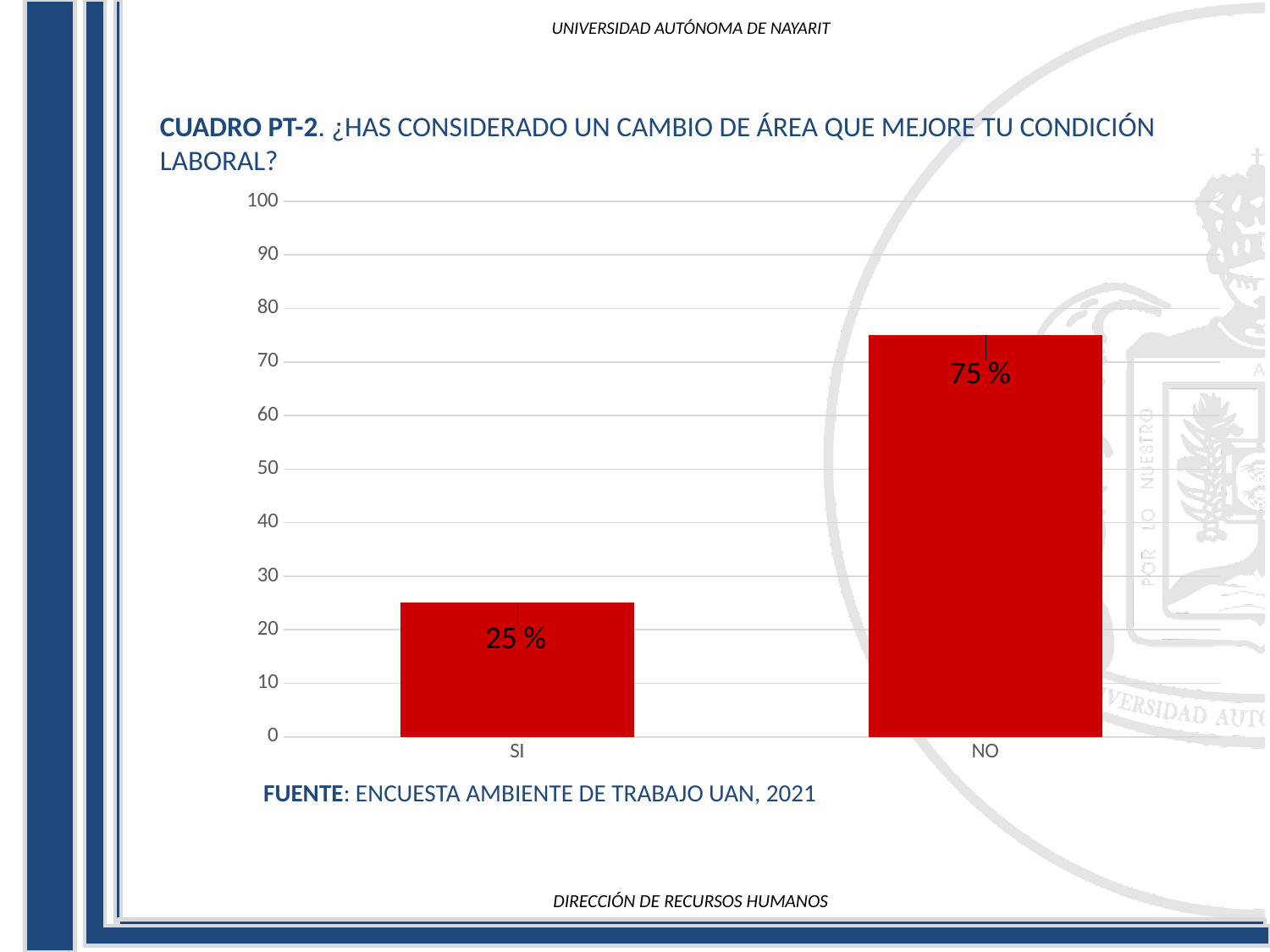
Which category has the lowest value? SI Which category has the highest value? NO What is the source cited below the chart? ENCUESTA AMBIENTE DE TRABAJO UAN, 2021 What is the value for NO? 75 % What is the value for SI? 25 % How many categories are shown on the x axis? 2 Is the value for NO greater or less than 70? greater What kind of chart is shown on the slide? bar chart Which is larger, the value for SI or the value for NO? NO Is the value for SI greater or less than 30? less What colour are the bars in the chart? red What is the difference between the values for NO and SI? 50 %